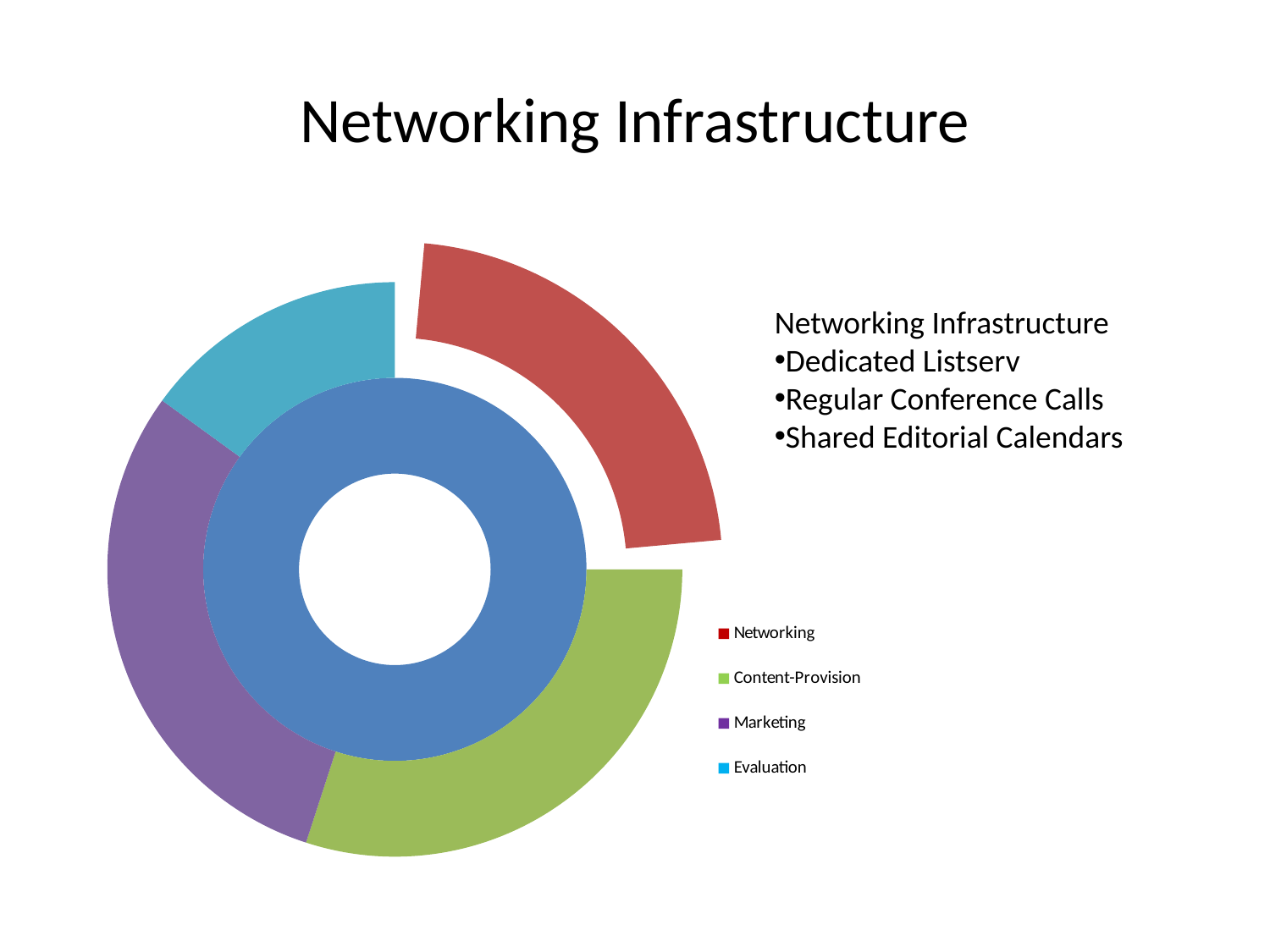
Which segment of the outer ring is pulled out (exploded) from the rest of the chart? Networking Which category has the smallest segment in the outer ring of the doughnut chart? Evaluation Which category is shown in red in the chart? Networking Which segment is larger in the outer ring: Networking or Evaluation? Networking What kind of chart is shown on the slide? Doughnut chart How many categories does the chart's legend list? 4 What is the title of the slide containing the chart? Networking Infrastructure Which segment is larger in the outer ring: Content-Provision or Evaluation? Content-Provision